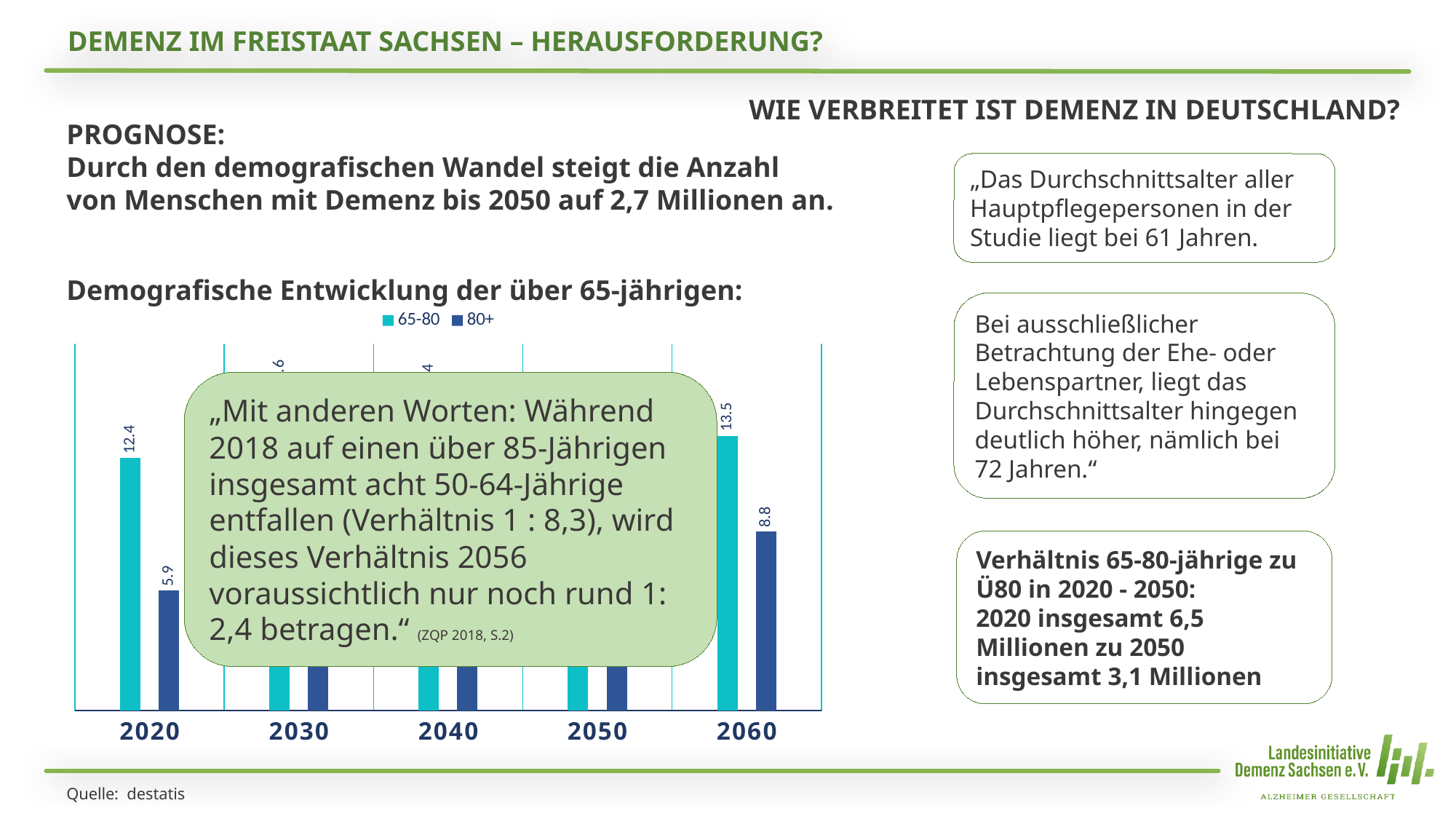
What is the value for the 80+ series in 2060? 8.8 What is the difference between the 65-80 and 80+ values in 2060? 4.7 Which series has the larger value in 2020, 65-80 or 80+? 65-80 What is the value for the 65-80 series in 2060? 13.5 Which year has the larger 80+ value, 2020 or 2060? 2060 By how much does the 80+ value in 2060 exceed the 80+ value in 2020? 2.9 What is the difference between the 65-80 and 80+ values in 2020? 6.5 What is the value for the 80+ series in 2020? 5.9 What kind of chart is shown on the slide? bar chart How many series does the chart legend list? 2 What is the value for the 65-80 series in 2020? 12.4 How many years are shown on the x axis of the chart? 5